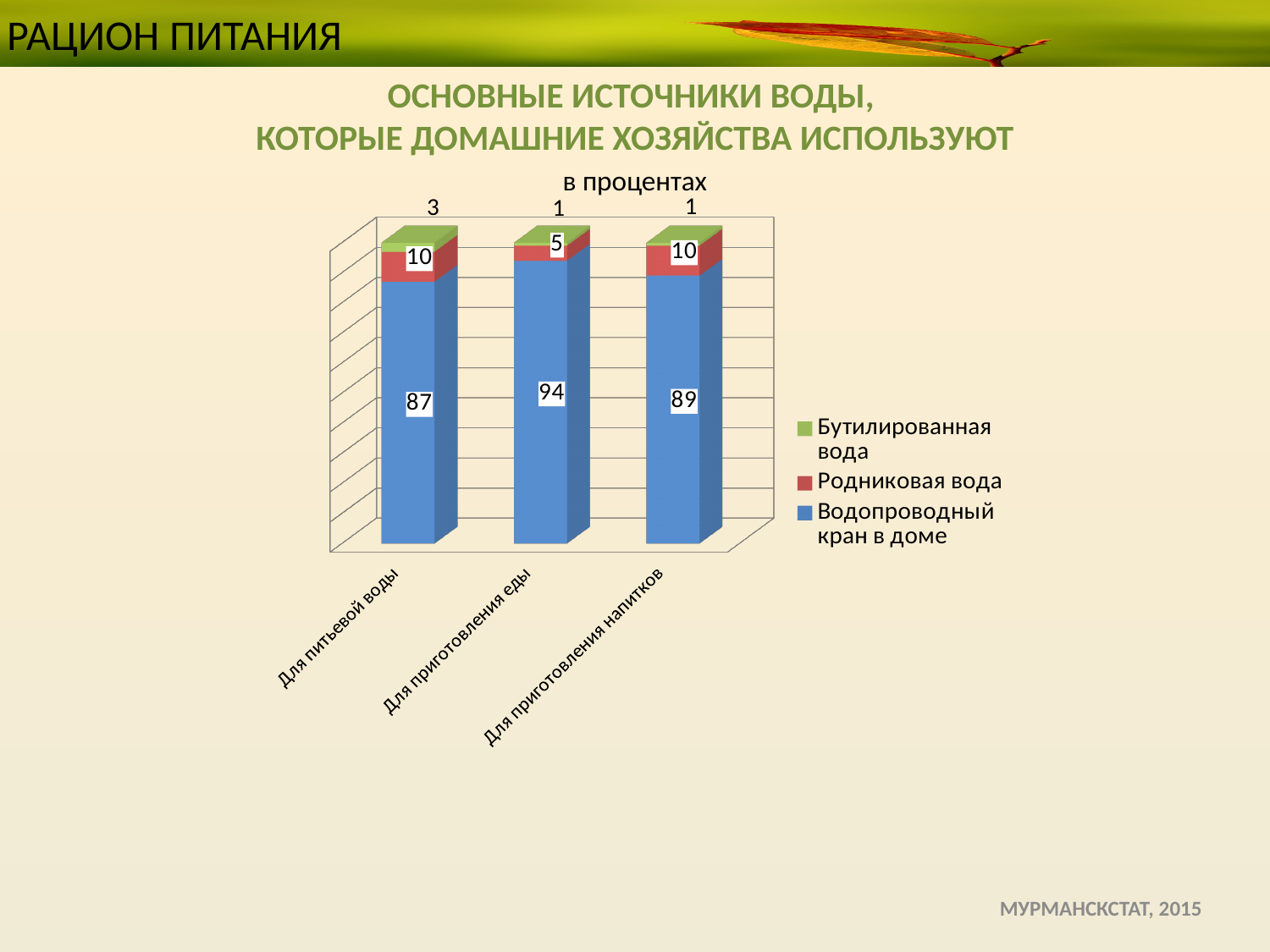
How many series does the legend list? 3 In which category is the value for "Родниковая вода" lowest? Для приготовления еды What is the value for "Водопроводный кран в доме" in the category "Для приготовления еды"? 94 How many categories are shown on the x axis? 3 What is the value for "Родниковая вода" in the category "Для питьевой воды"? 10 What is the difference between the "Водопроводный кран в доме" values for "Для приготовления еды" and "Для питьевой воды"? 7 What type of chart is shown on the slide? stacked bar chart What is the total of the stacked bar for "Для приготовления напитков"? 100 In which category is the value for "Водопроводный кран в доме" highest? Для приготовления еды What is the value for "Бутилированная вода" in the category "Для питьевой воды"? 3 What is the value for "Бутилированная вода" in the category "Для приготовления напитков"? 1 Which series is shown in green in the legend? Бутилированная вода